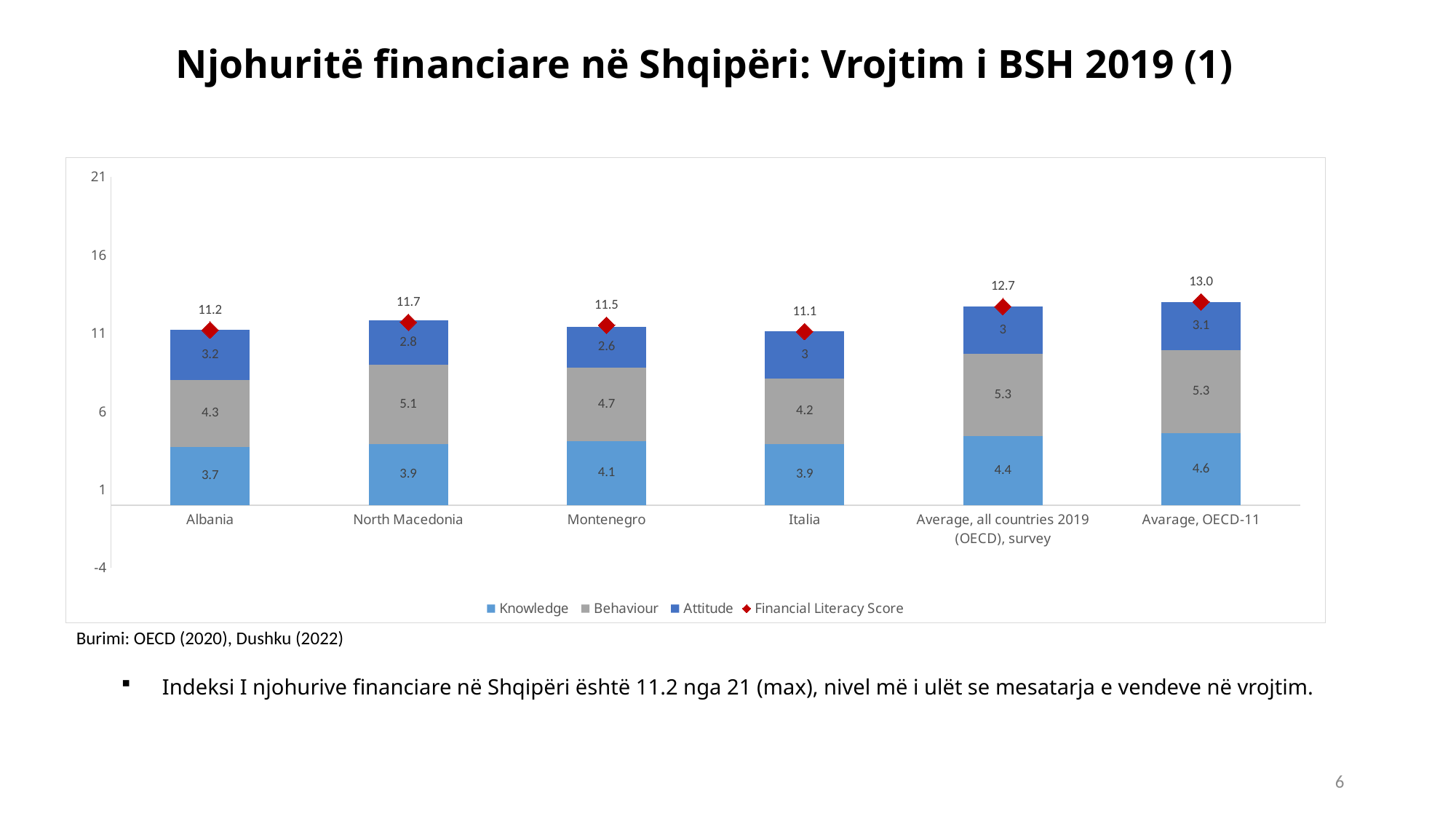
What kind of chart is shown on the slide? Stacked bar chart with markers What is the total of the stacked bar for Average, all countries 2019 (OECD), survey? 12.7 How many series does the legend list? 4 Which has a higher Knowledge value, Montenegro or Italia? Montenegro What is the difference between the Financial Literacy Score of Avarage, OECD-11 and Albania? 1.8 How many categories are shown on the x axis? 6 What is the Behaviour value for North Macedonia? 5.1 What is the Knowledge value for Albania? 3.7 Which category has the lowest Financial Literacy Score? Italia What is the Financial Literacy Score for Italia? 11.1 Which category has the highest Financial Literacy Score? Avarage, OECD-11 What is the Attitude value for Montenegro? 2.6